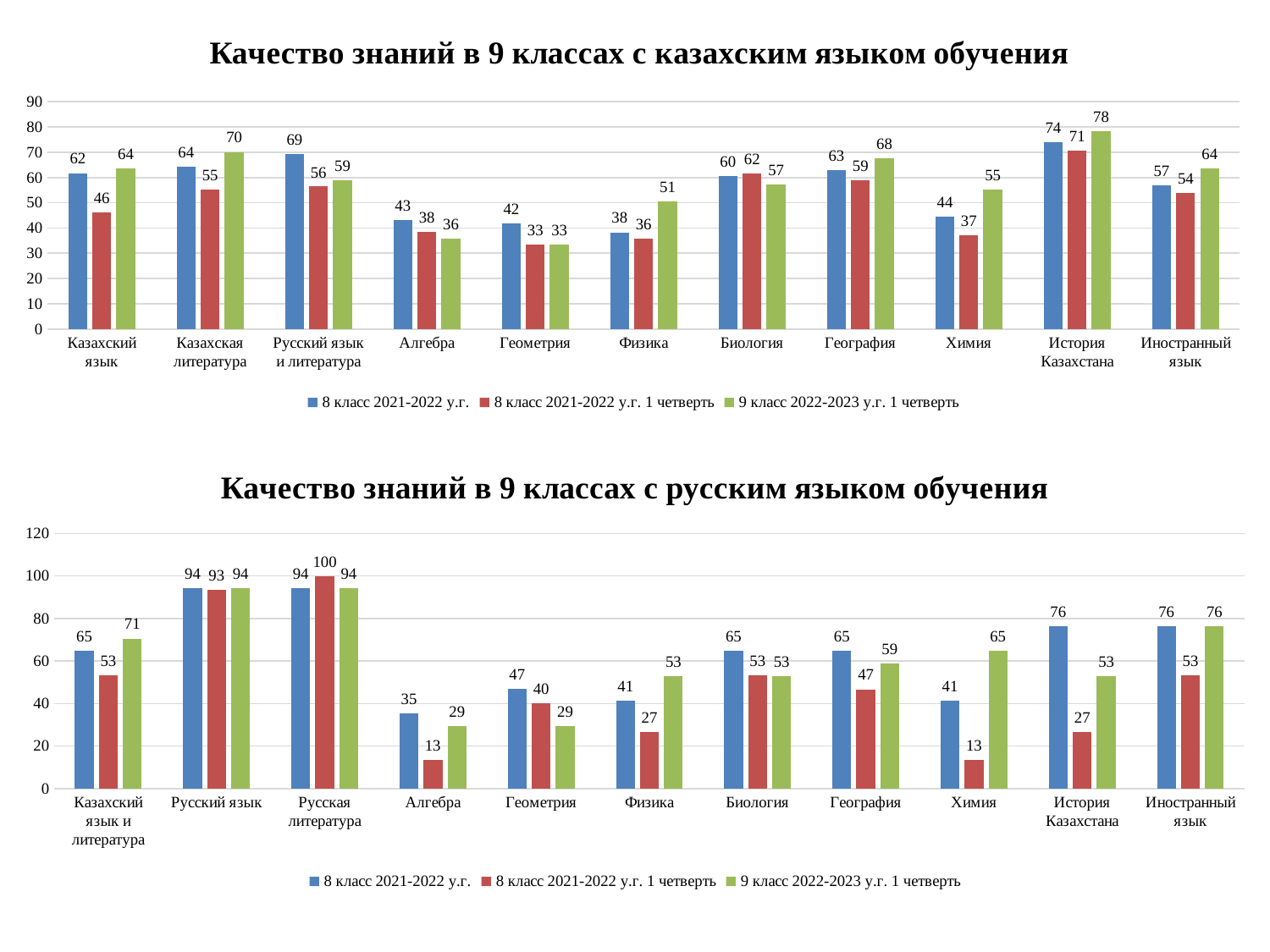
What type of chart is the top chart (Качество знаний в 9 классах с казахским языком обучения)? Bar chart How many series does the legend of the bottom chart (Качество знаний в 9 классах с русским языком обучения) list? 3 In the top chart (Качество знаний в 9 классах с казахским языком обучения), what is the difference between the 9 класс 2022-2023 у.г. 1 четверть value and the 8 класс 2021-2022 у.г. 1 четверть value for Химия? 18 In the top chart (Качество знаний в 9 классах с казахским языком обучения), what is the value for Физика in the series 9 класс 2022-2023 у.г. 1 четверть? 51 In the top chart (Качество знаний в 9 классах с казахским языком обучения), which category has the lowest value in the series 8 класс 2021-2022 у.г. 1 четверть? Геометрия In the bottom chart (Качество знаний в 9 классах с русским языком обучения), which is larger for Химия: the 8 класс 2021-2022 у.г. value or the 9 класс 2022-2023 у.г. 1 четверть value? 9 класс 2022-2023 у.г. 1 четверть In the bottom chart (Качество знаний в 9 классах с русским языком обучения), what is the value for Русская литература in the series 8 класс 2021-2022 у.г. 1 четверть? 100 In the top chart (Качество знаний в 9 классах с казахским языком обучения), what is the value for Алгебра in the series 8 класс 2021-2022 у.г.? 43 In the bottom chart (Качество знаний в 9 классах с русским языком обучения), which category has the lowest value in the series 9 класс 2022-2023 у.г. 1 четверть? Алгебра and Геометрия (both 29) In the top chart (Качество знаний в 9 классах с казахским языком обучения), how many categories are shown on the x axis? 11 In the bottom chart (Качество знаний в 9 классах с русским языком обучения), what is the difference between the 8 класс 2021-2022 у.г. value and the 8 класс 2021-2022 у.г. 1 четверть value for История Казахстана? 49 In the top chart (Качество знаний в 9 классах с казахским языком обучения), which category has the highest value in the series 9 класс 2022-2023 у.г. 1 четверть? История Казахстана